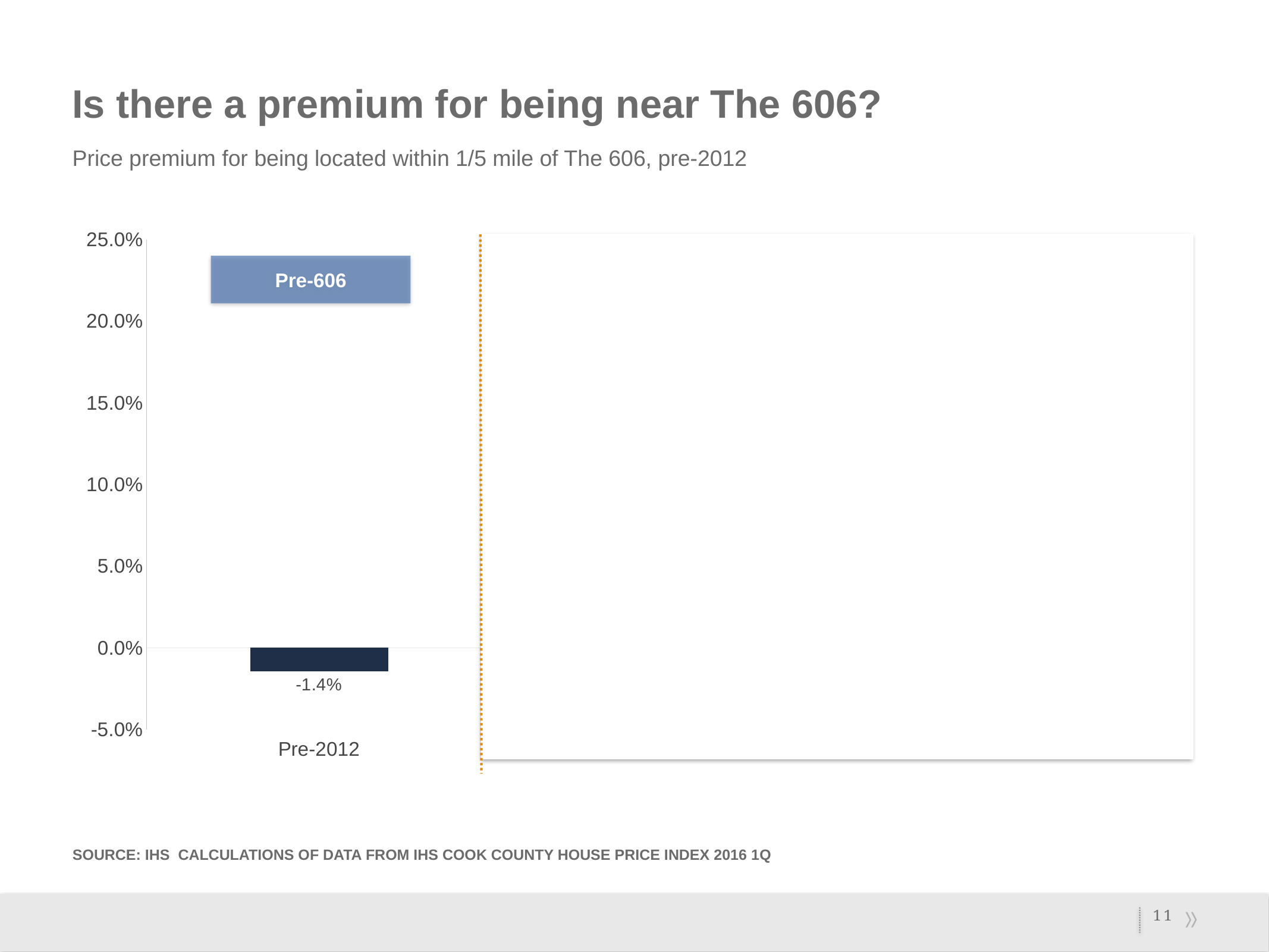
Is the value for Pre-2012 greater or less than -5.0%? greater Is the value for Pre-2012 greater or less than 0.0%? less What kind of chart is shown on the slide? bar chart What is the highest value shown on the y axis? 25.0% What is the category label shown on the x axis? Pre-2012 Is the value for Pre-2012 positive or negative? negative What is the value shown for Pre-2012? -1.4% How many bars are plotted on the chart? 1